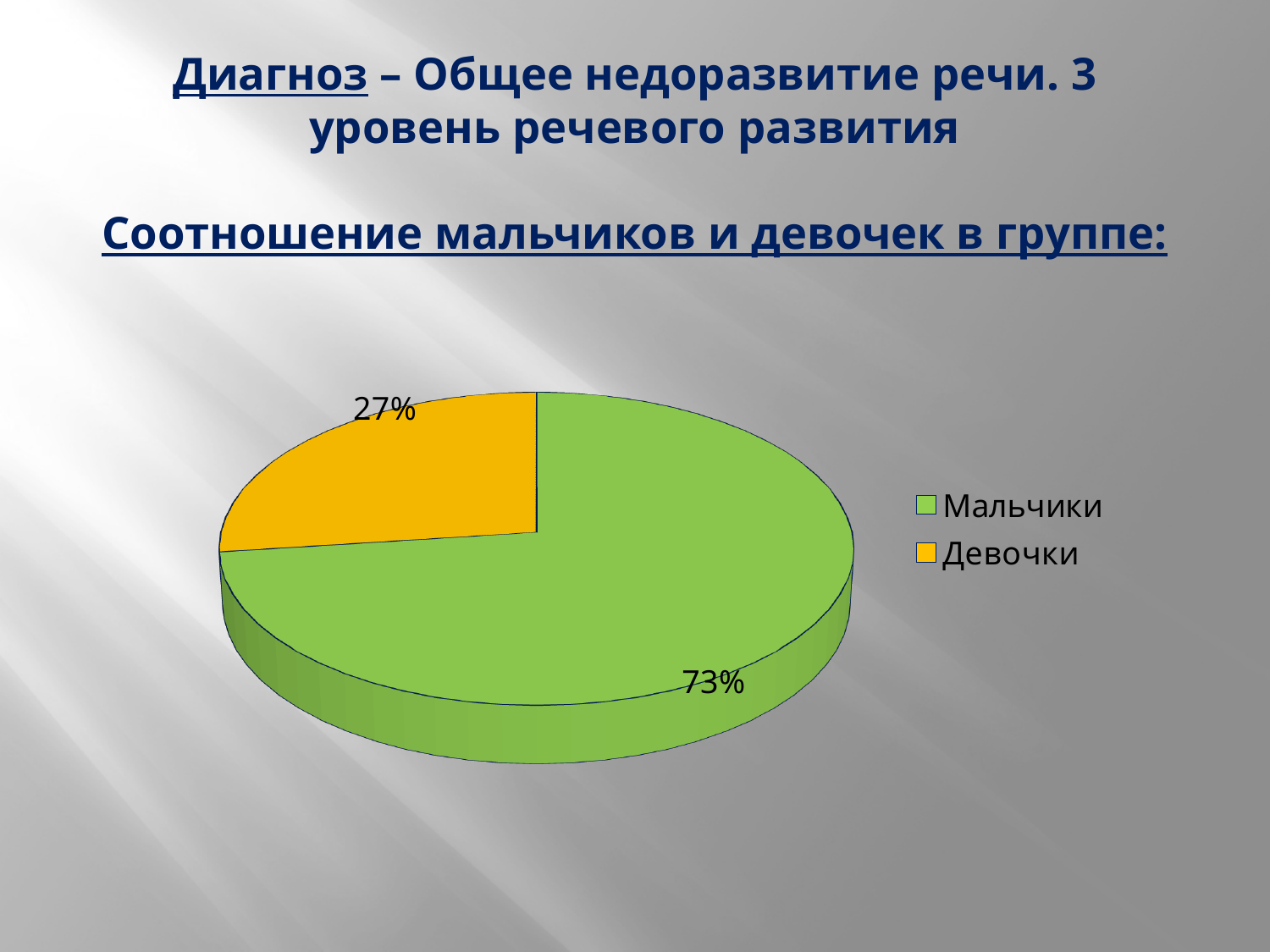
What is the difference in percentage points between the Мальчики and Девочки slices? 46 What kind of chart is shown on the slide? pie chart What share of the pie does Девочки (girls) take? 27% How many slices does the pie chart have? 2 What colour is the Девочки slice? yellow What share of the pie does Мальчики (boys) take? 73% Which is larger, the share for Мальчики or the share for Девочки? Мальчики What colour is the Мальчики slice? green How many entries does the legend list? 2 Which category has the smallest slice of the pie? Девочки Which category has the largest slice of the pie? Мальчики